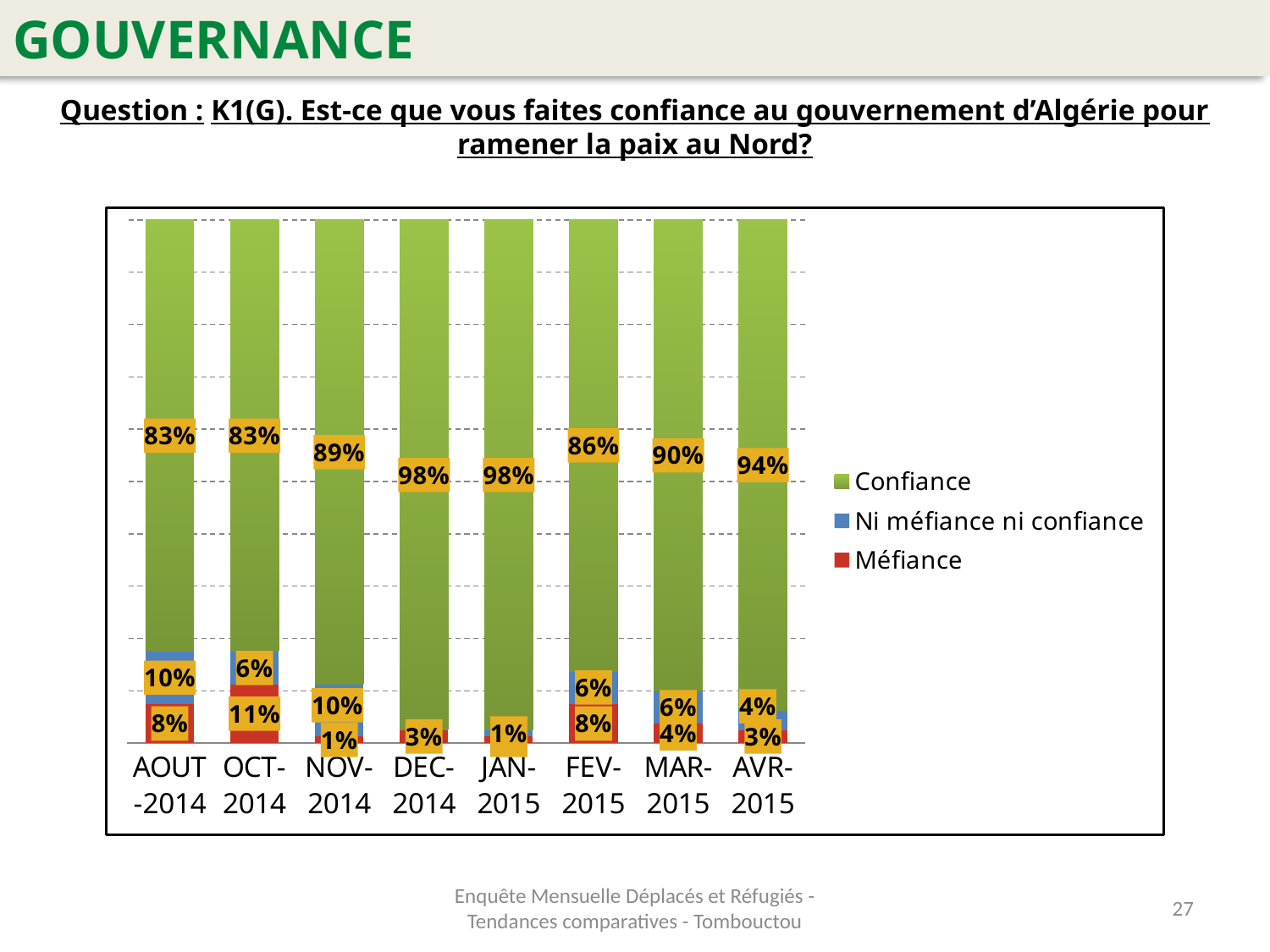
Which month has a higher Confiance value, NOV-2014 or FEV-2015? NOV-2014 Does the Confiance value rise or fall from FEV-2015 to AVR-2015? Rise In which month is Méfiance lowest among the months where its label is shown? NOV-2014 and JAN-2015 (tied at 1%) What is the value of Confiance for DEC-2014? 98% What is the value of Ni méfiance ni confiance for AVR-2015? 4% How many series does the legend list? 3 In which month is Méfiance highest? OCT-2014 What is the value of Méfiance for MAR-2015? 4% What kind of chart is shown on the slide? Stacked bar chart What is the difference in Confiance between AVR-2015 and MAR-2015? 4 percentage points How many months are shown on the x axis? 8 What is the value of Méfiance for OCT-2014? 11%